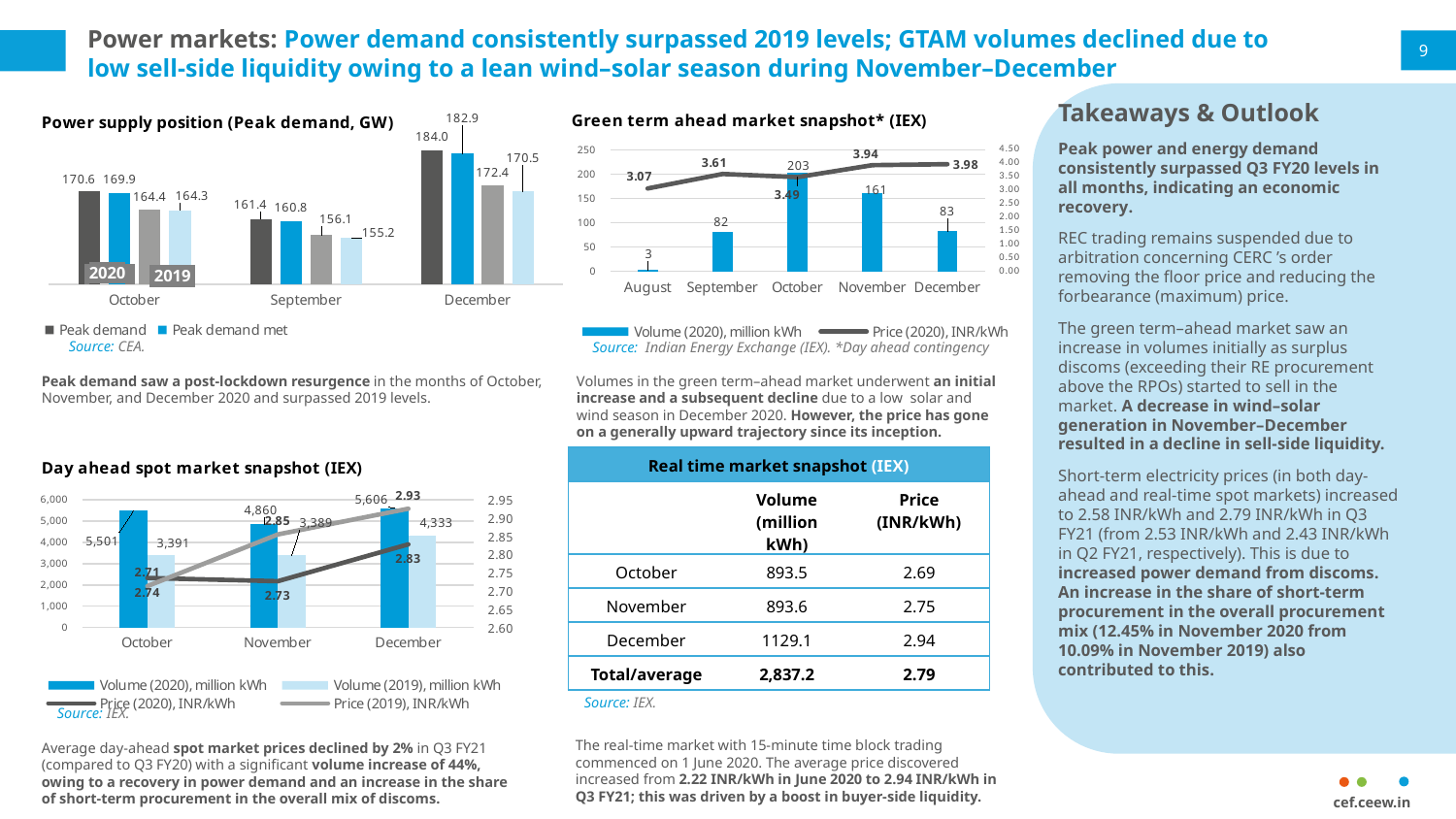
How many months are shown on the x axis of the Green term ahead market snapshot chart? 5 In the Green term ahead market snapshot chart, which month has the highest volume? October In the Day ahead spot market snapshot chart, what is the Volume (2020) for December? 5,606 What kind of chart is the Power supply position chart? Bar chart How many series does the legend of the Day ahead spot market snapshot chart list? 4 In the Power supply position chart, what is the 2019 peak demand met for September? 155.2 In the Power supply position chart, what is the difference between the 2020 peak demand and the 2019 peak demand for October? 6.2 In the Green term ahead market snapshot chart, what is the price for December? 3.98 In the Power supply position chart, what is the 2020 peak demand for December? 184.0 In the Green term ahead market snapshot chart, which month has the lowest volume? August In the Green term ahead market snapshot chart, what is the volume for October? 203 In the Green term ahead market snapshot chart, what is the difference in volume between October and November? 42